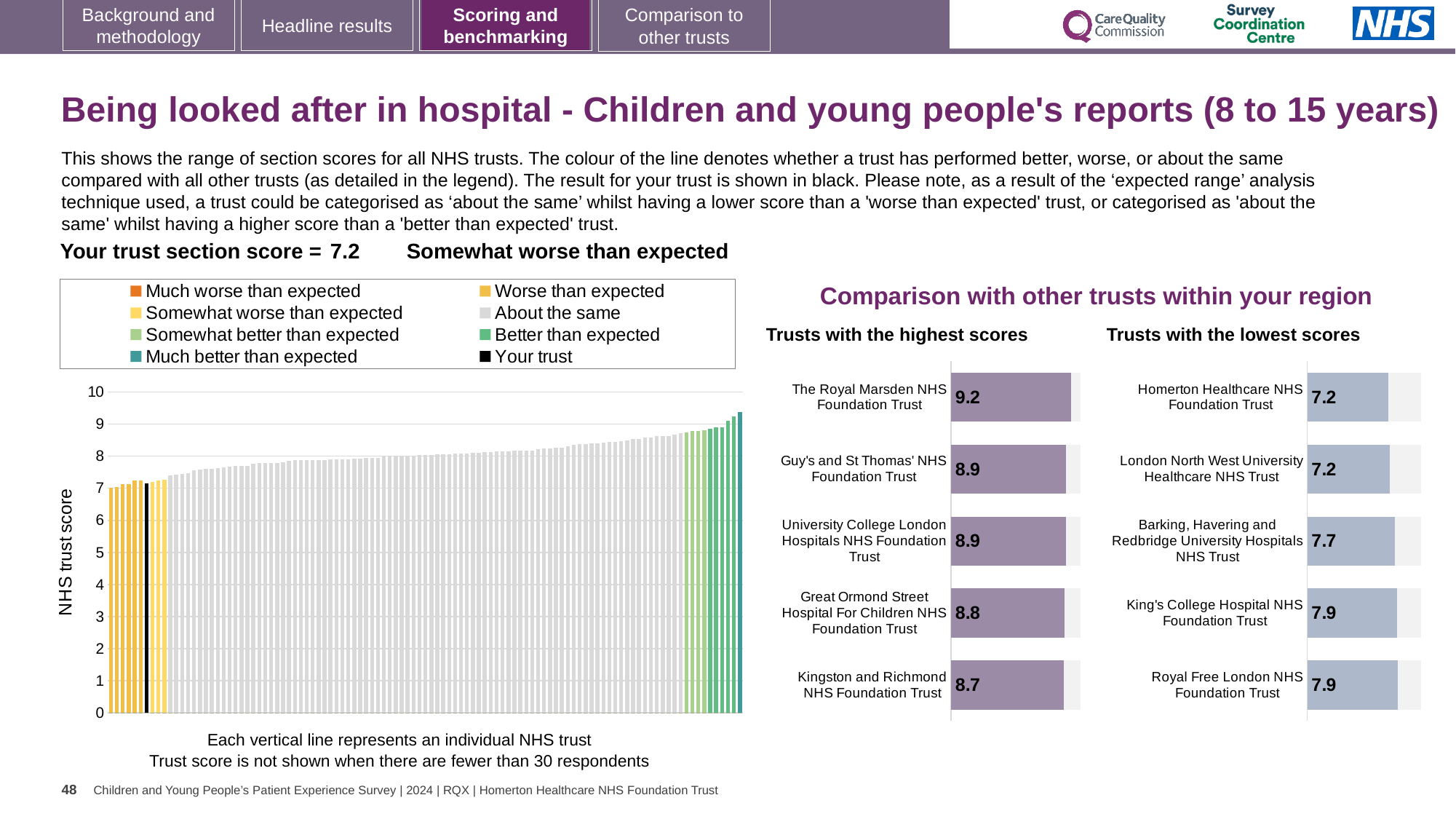
How many entries does the legend above the large chart on the left list? 8 In the large chart on the left, is the highest trust score greater or less than 9? greater In the 'Trusts with the highest scores' chart, what is the difference between The Royal Marsden NHS Foundation Trust and Kingston and Richmond NHS Foundation Trust? 0.5 In the large chart on the left, do the trust scores rise or fall from left to right? Rise What kind of chart is the large chart on the left showing NHS trust scores? Bar chart How many trusts are listed in the 'Trusts with the highest scores' chart? 5 In the 'Trusts with the lowest scores' chart, which is larger: the score for King's College Hospital NHS Foundation Trust or Barking, Havering and Redbridge University Hospitals NHS Trust? King's College Hospital NHS Foundation Trust In the 'Trusts with the highest scores' chart, which trust has the lowest score shown? Kingston and Richmond NHS Foundation Trust In the 'Trusts with the lowest scores' chart, what is the score for Homerton Healthcare NHS Foundation Trust? 7.2 In the 'Trusts with the lowest scores' chart, what is the difference between Royal Free London NHS Foundation Trust and Homerton Healthcare NHS Foundation Trust? 0.7 In the 'Trusts with the highest scores' chart, what is the score for The Royal Marsden NHS Foundation Trust? 9.2 In the 'Trusts with the lowest scores' chart, what is the score for Barking, Havering and Redbridge University Hospitals NHS Trust? 7.7